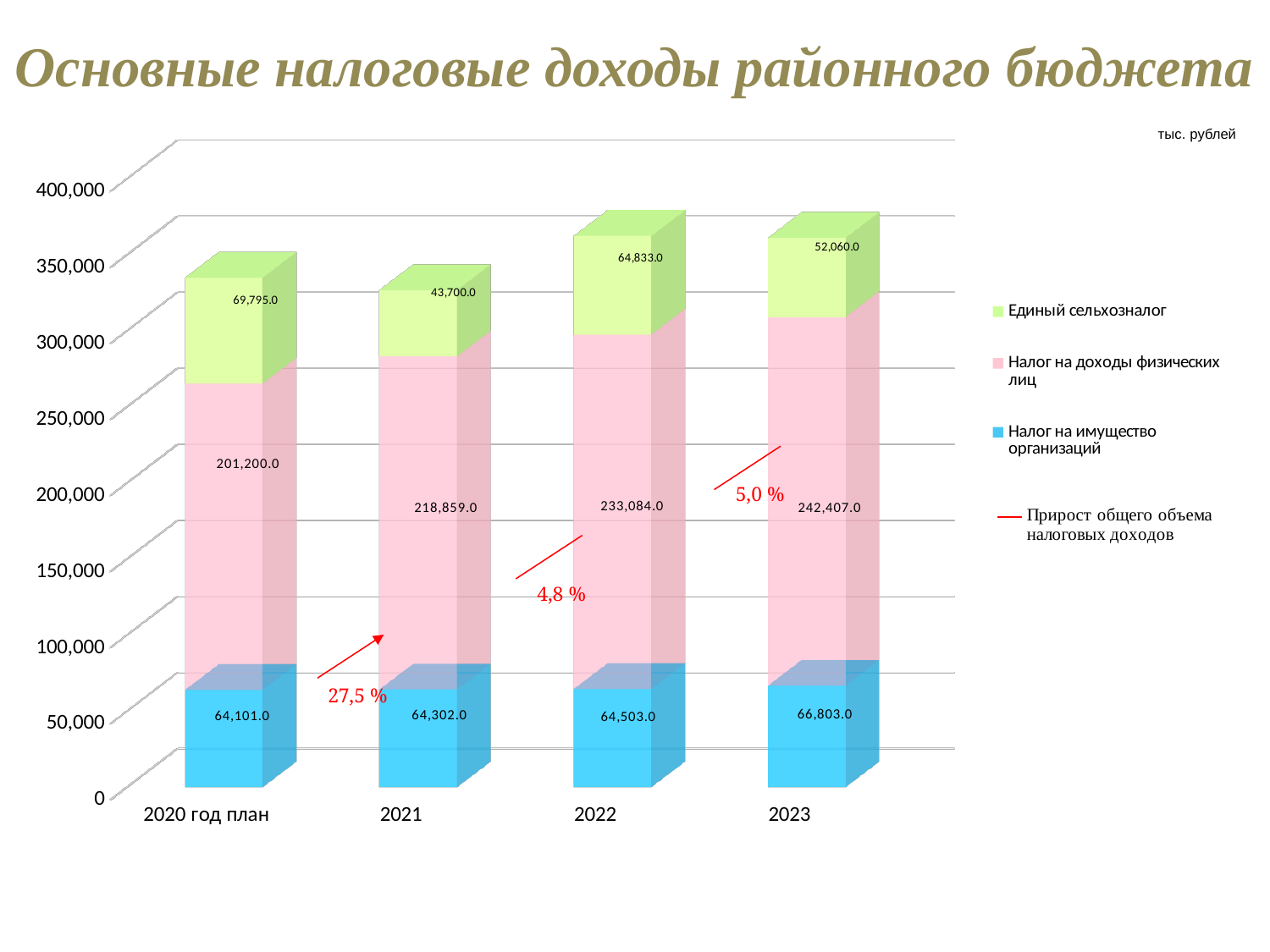
What is the difference between Налог на доходы физических лиц in 2022 and in 2021? 14,225.0 Which year has the highest value for Налог на доходы физических лиц? 2023 How many years (categories) are shown on the x axis? 4 Which year has the lowest value for Единый сельхозналог? 2021 What is the value of Налог на доходы физических лиц for 2023? 242,407.0 What kind of chart is shown on the slide? Stacked bar chart Which is larger: Единый сельхозналог in 2020 год план or in 2022? 2020 год план What is the value of Налог на имущество организаций for 2020 год план? 64,101.0 How many entries does the legend list? 4 What is the value of Единый сельхозналог for 2021? 43,700.0 What is the total of the stacked bar for 2022? 362,420.0 Does Налог на доходы физических лиц rise or fall from 2020 год план to 2023? Rises